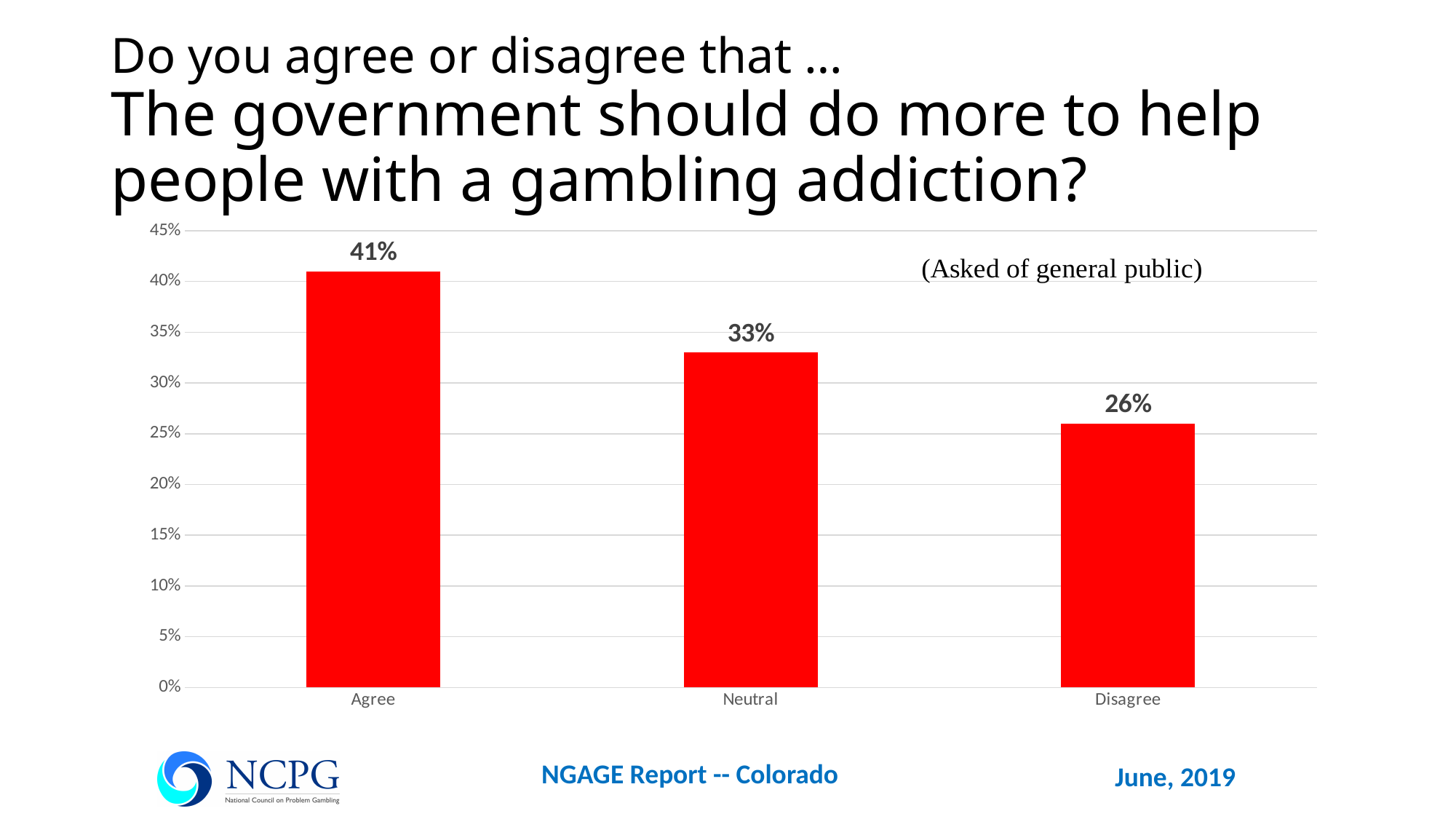
Which is larger, the value for Neutral or the value for Disagree? Neutral Do the values rise or fall from left to right across the categories? Fall What is the difference between the Agree and Neutral percentages? 8% What kind of chart is shown on the slide? Bar chart What percentage of respondents chose Neutral? 33% What percentage of respondents chose Agree? 41% Which response category has the lowest value? Disagree Is the value for Neutral greater or less than 30%? greater How many response categories are shown on the chart? 3 Which response category has the highest value? Agree What is the difference between the Agree and Disagree percentages? 15% What percentage of respondents chose Disagree? 26%